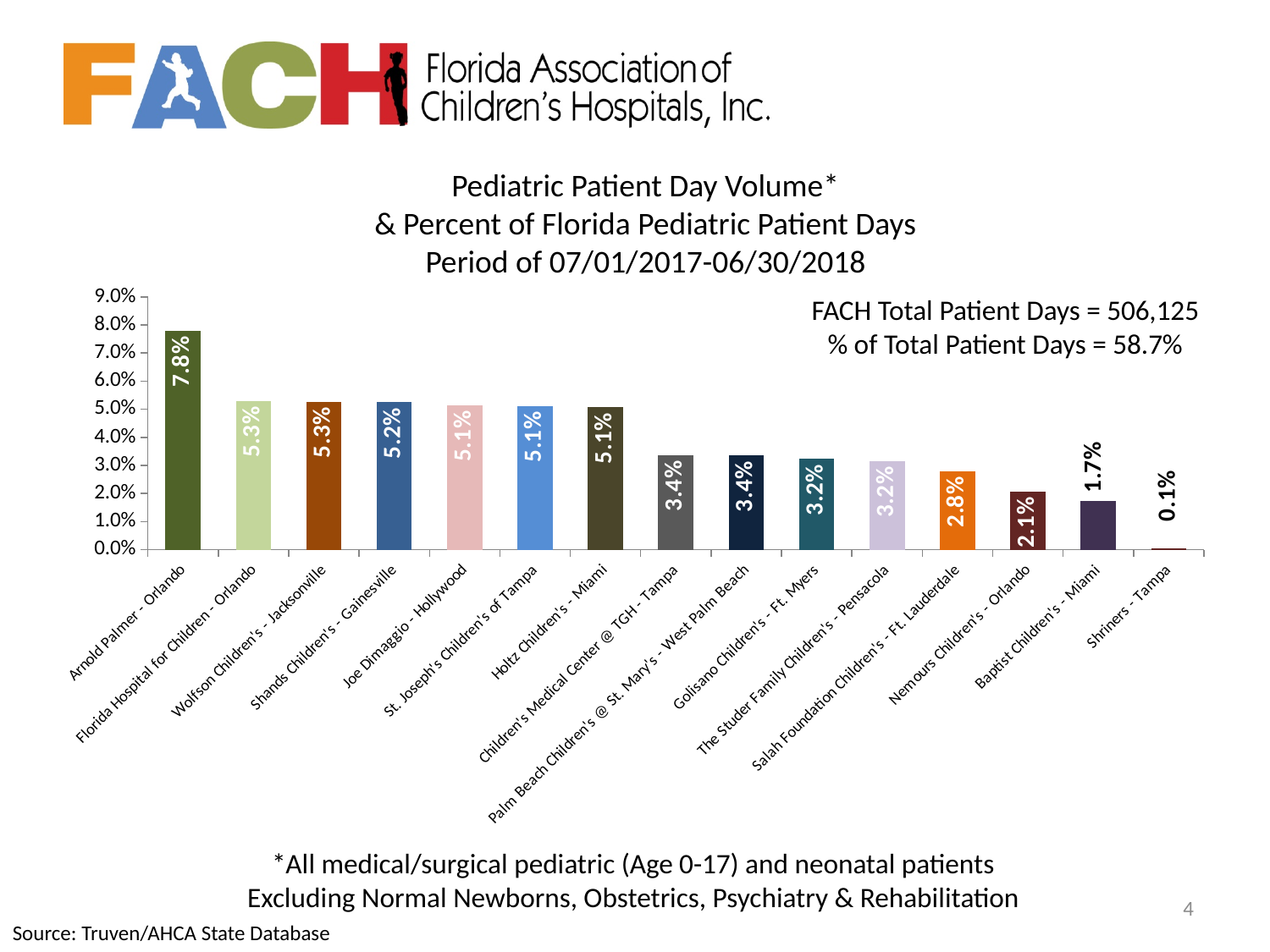
Which hospital has the lowest percentage of Florida pediatric patient days? Shriners - Tampa What value is shown for Salah Foundation Children's - Ft. Lauderdale? 2.8% What value is shown for Baptist Children's - Miami? 1.7% What value is shown for Nemours Children's - Orlando? 2.1% Which hospital has the highest percentage of Florida pediatric patient days? Arnold Palmer - Orlando Which has a larger value, Holtz Children's - Miami or Golisano Children's - Ft. Myers? Holtz Children's - Miami What percentage of Florida pediatric patient days is shown for Arnold Palmer - Orlando? 7.8% What kind of chart is shown on the slide? Bar chart What is the difference in percentage points between Arnold Palmer - Orlando and Shriners - Tampa? 7.7 percentage points Do the values generally rise or fall moving from left to right along the x axis? Fall According to the text on the chart, what is the FACH Total Patient Days figure? 506,125 How many hospitals are shown on the chart? 15